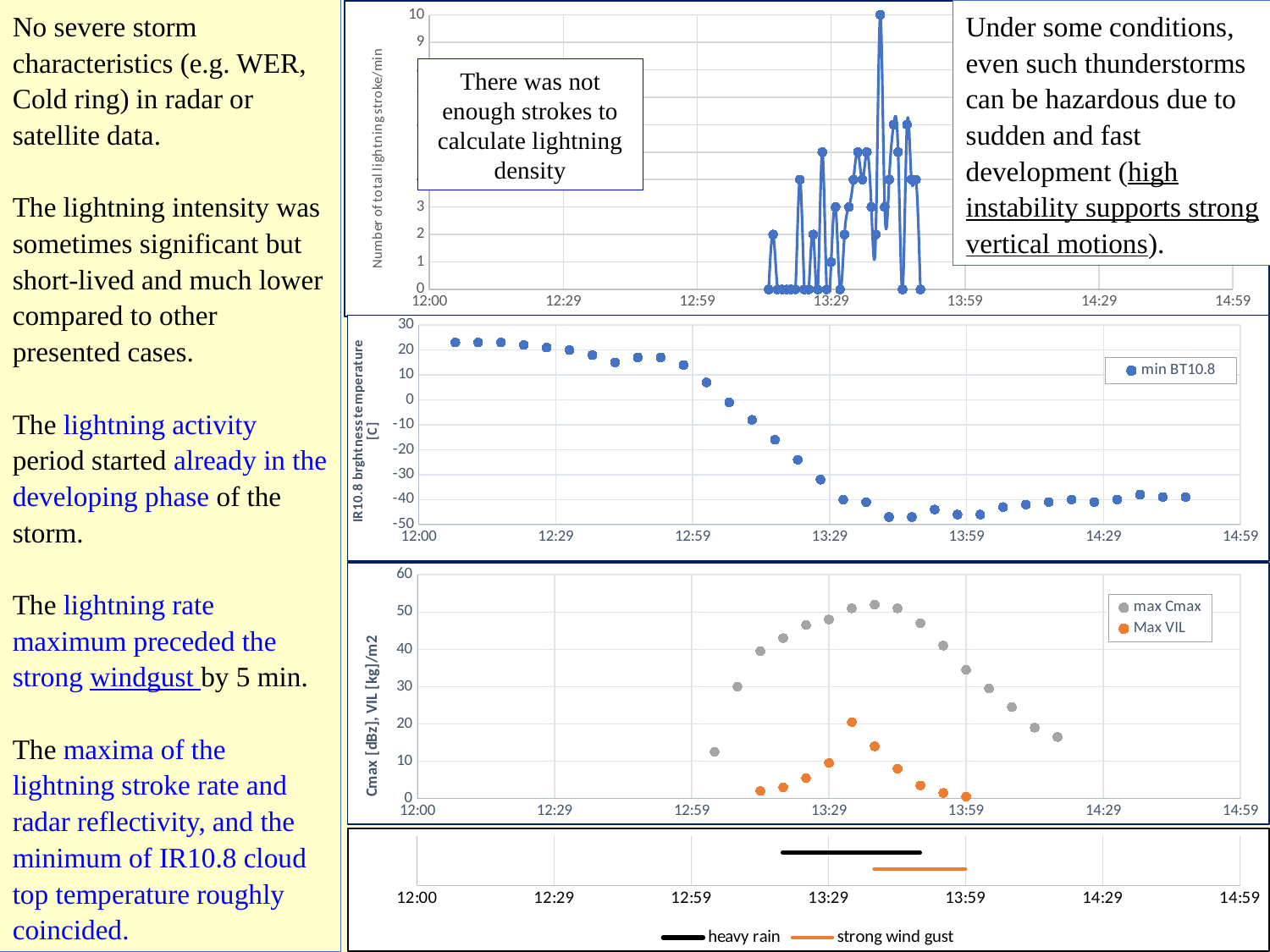
In the top chart (number of total lightning strokes per minute), what is the highest value reached? 10 In the middle chart (IR10.8 brightness temperature), what series does the legend list? min BT10.8 In the third chart, which series has the larger value at 13:29, max Cmax or Max VIL? max Cmax In the middle chart, is the min BT10.8 value at about 13:59 greater or less than -40? less In the third chart, is the peak max Cmax value greater or less than 50? greater In the bottom chart, which event starts earlier, heavy rain or strong wind gust? heavy rain In the middle chart, does the min BT10.8 value rise or fall between 12:00 and 13:29? fall In the top chart, what is the lowest value plotted for the lightning stroke rate? 0 In the middle chart, is the first min BT10.8 value (just after 12:00) greater or less than 20? greater In the third chart (Cmax and VIL), how many series does the legend list? 2 In the middle chart, how many series does the legend list? 1